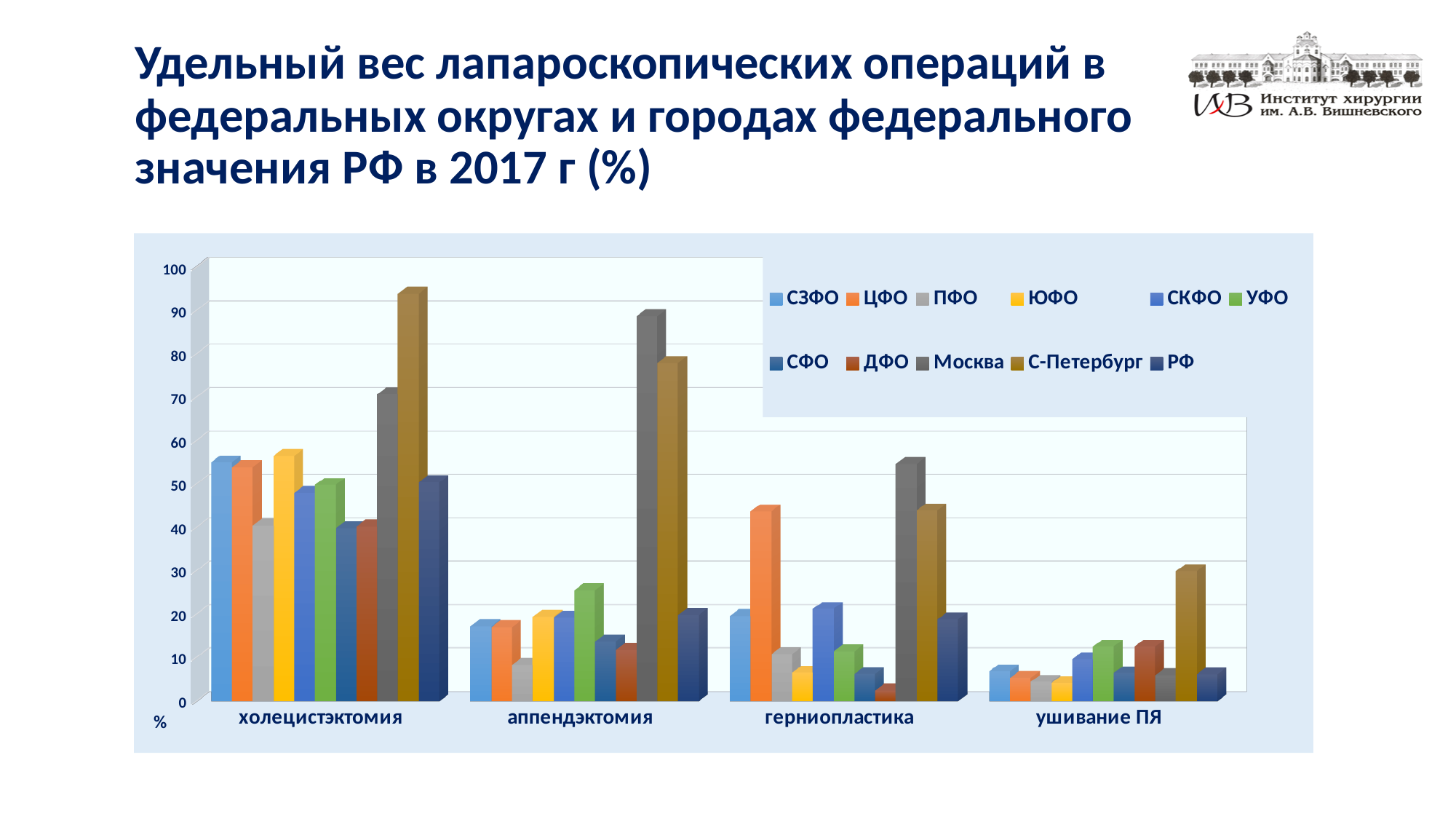
Which region has the highest value for ушивание ПЯ? С-Петербург How many series does the chart legend list? 11 In герниопластика, which is larger: the value for Москва or the value for С-Петербург? Москва What kind of chart is shown on the slide? bar chart Is the value for Москва in аппендэктомия greater or less than 80? greater Is the value for ЦФО in герниопластика greater or less than 40? greater How many operation categories are shown on the x axis of the chart? 4 Which region has the lowest value for герниопластика? ДФО What year does the slide title say the data refers to? 2017 Which region has the highest value for холецистэктомия? С-Петербург Which region has the highest value for аппендэктомия? Москва Is the value for С-Петербург in холецистэктомия greater or less than 90? greater